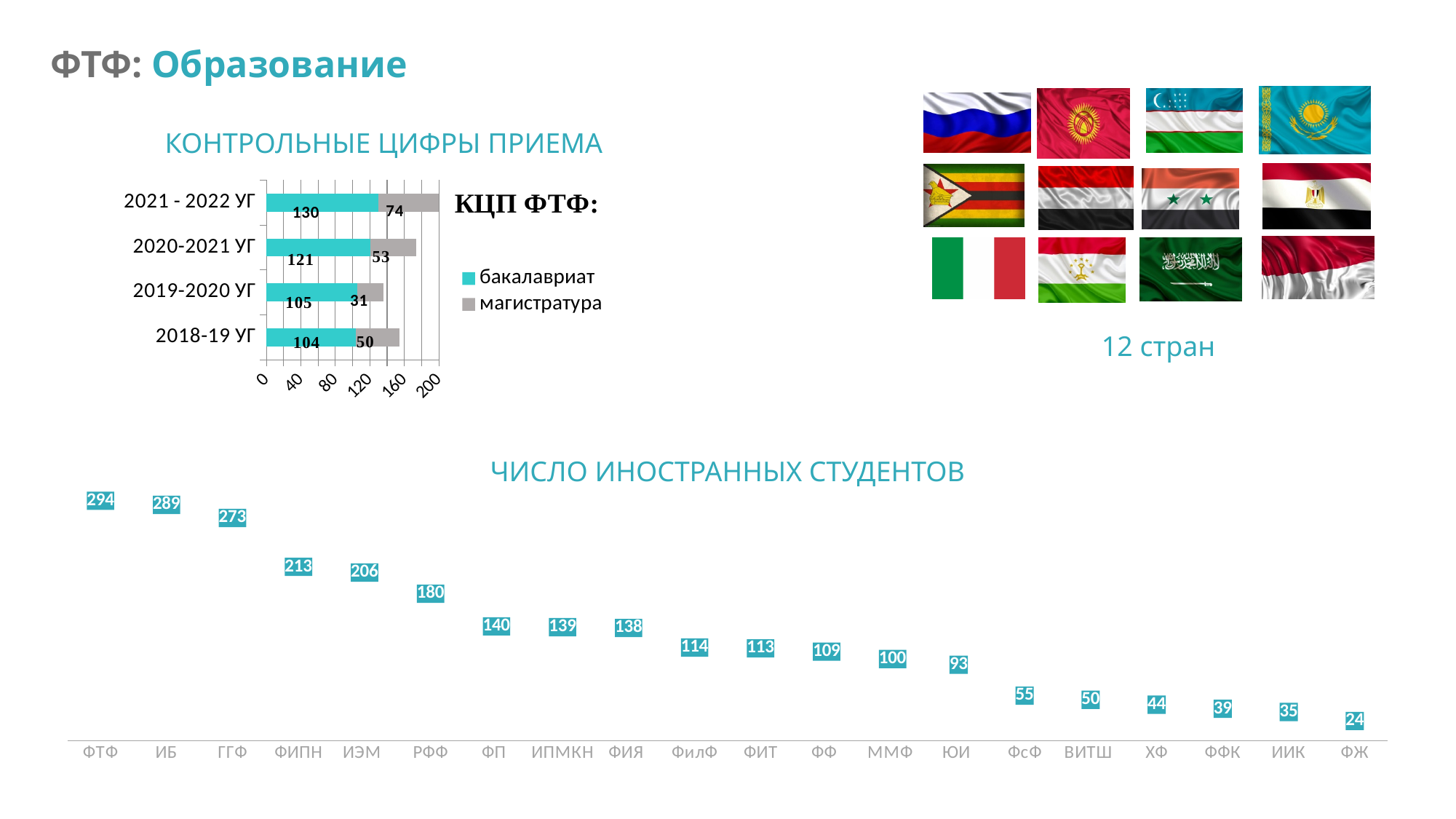
In the chart 'ЧИСЛО ИНОСТРАННЫХ СТУДЕНТОВ', what is the value for ИЭМ? 206 In the chart 'КОНТРОЛЬНЫЕ ЦИФРЫ ПРИЕМА', what is the total of the stacked bar for 2020-2021 УГ? 174 In the chart 'КОНТРОЛЬНЫЕ ЦИФРЫ ПРИЕМА', which year has the highest магистратура value? 2021 - 2022 УГ In the chart 'ЧИСЛО ИНОСТРАННЫХ СТУДЕНТОВ', do the values rise or fall from left to right along the x axis? Fall In the chart 'КОНТРОЛЬНЫЕ ЦИФРЫ ПРИЕМА', what kind of chart is shown? Stacked bar chart In the chart 'ЧИСЛО ИНОСТРАННЫХ СТУДЕНТОВ', which is larger, the value for ФИТ or the value for ММФ? ФИТ In the chart 'ЧИСЛО ИНОСТРАННЫХ СТУДЕНТОВ', which category has the lowest value? ФЖ In the chart 'КОНТРОЛЬНЫЕ ЦИФРЫ ПРИЕМА', what is the value for магистратура in 2019-2020 УГ? 31 In the chart 'ЧИСЛО ИНОСТРАННЫХ СТУДЕНТОВ', how many categories are shown? 20 In the chart 'КОНТРОЛЬНЫЕ ЦИФРЫ ПРИЕМА', what is the difference between the бакалавриат values for 2021 - 2022 УГ and 2018-19 УГ? 26 In the chart 'КОНТРОЛЬНЫЕ ЦИФРЫ ПРИЕМА', how many series does the legend list? 2 In the chart 'КОНТРОЛЬНЫЕ ЦИФРЫ ПРИЕМА', what is the value for бакалавриат in 2021 - 2022 УГ? 130